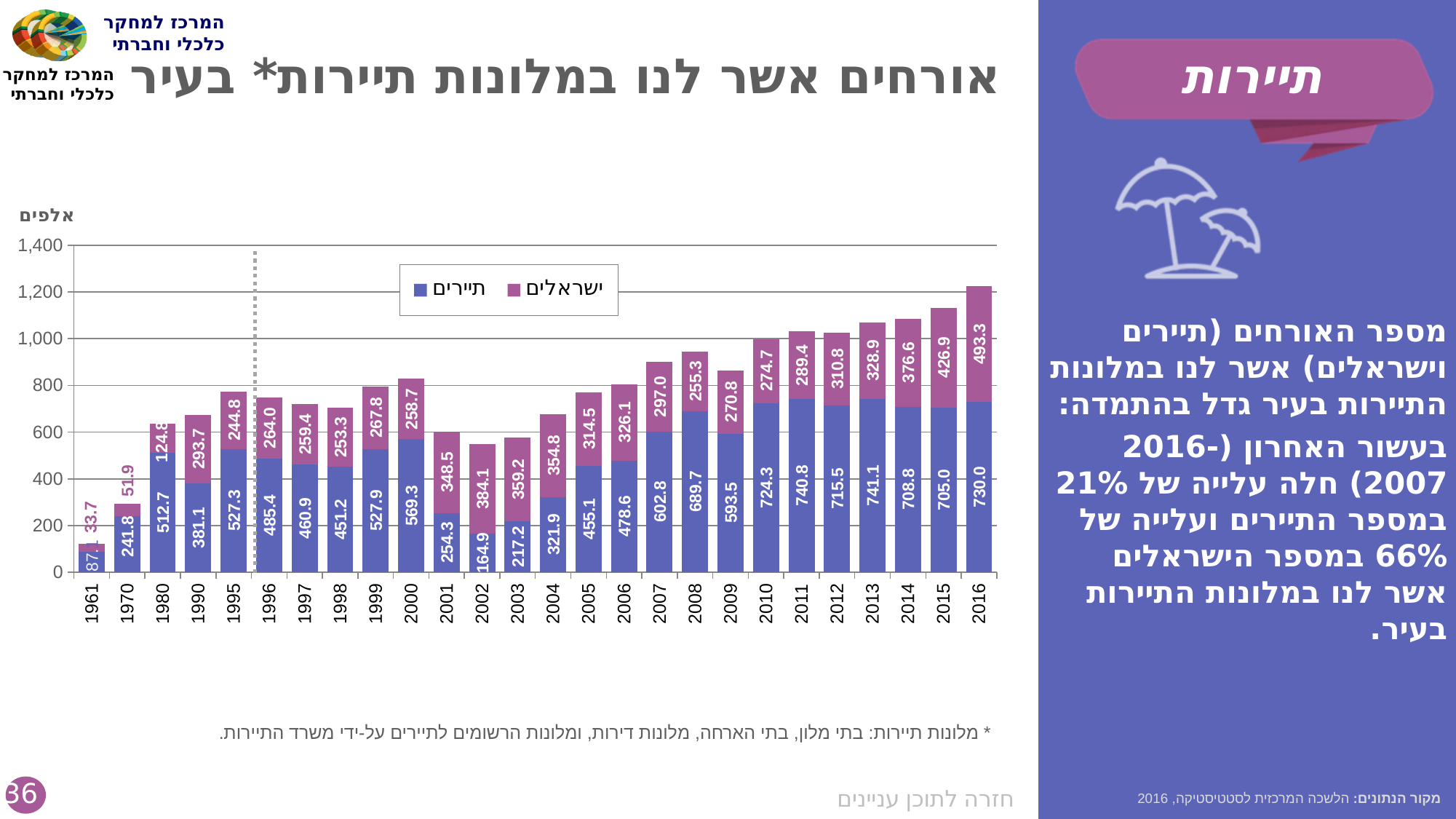
Is the total of the stacked bar for 2002 greater or less than 600? less What is the value for תיירים (tourists) in 2000? 569.3 What is the value for ישראלים (Israelis) in 2002? 384.1 In 2002, which is larger: the value for תיירים (tourists) or the value for ישראלים (Israelis)? ישראלים (Israelis) How many series does the chart legend list? 2 What is the difference between the תיירים (tourists) value and the ישראלים (Israelis) value in 2016? 236.7 In which year is the value for ישראלים (Israelis) the lowest? 1961 In which year is the value for ישראלים (Israelis) the highest? 2016 What is the value for תיירים (tourists) in 2016? 730.0 What is the total of the stacked bar for 2016? 1223.3 What kind of chart is shown on the slide? Stacked bar chart How many years (categories) are shown on the x axis of the chart? 26